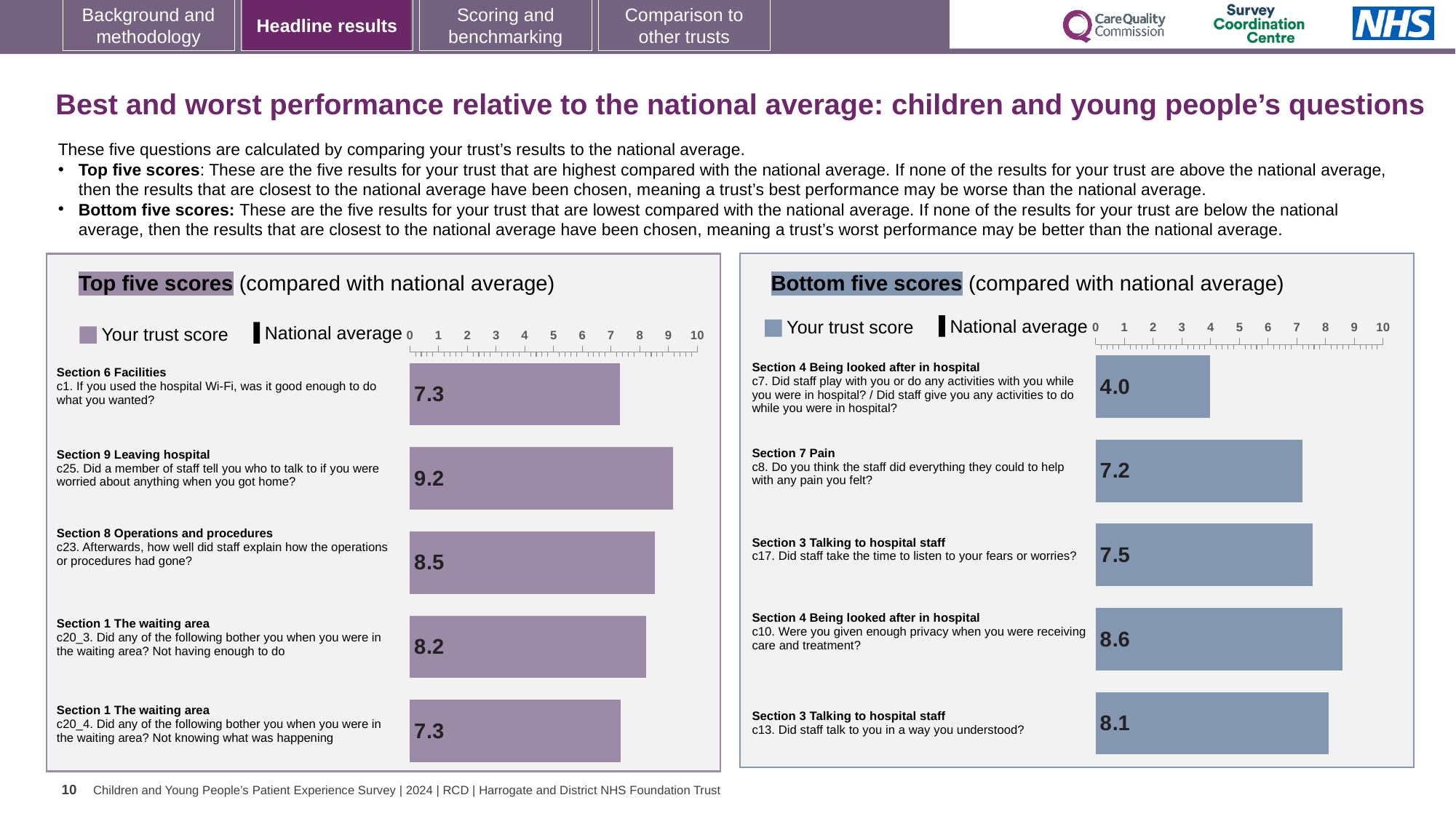
In the Bottom five scores chart, is the trust score for c8 (staff did everything they could to help with pain) greater or less than 5? greater In the Top five scores chart, what is the difference between the trust scores for c25 and c23? 0.7 In the Bottom five scores chart, which has the higher trust score: c10 (privacy when receiving care) or c13 (staff talk to you in a way you understood)? c10 In the Bottom five scores chart, which question has the lowest trust score? c7 (Section 4 Being looked after in hospital) What type of chart is used for the Bottom five scores? Bar chart In the Bottom five scores chart, what is the difference between the trust scores for c10 and c7? 4.6 How many questions are shown in the Top five scores chart? 5 In the Top five scores chart, which question has the highest trust score? c25 (Section 9 Leaving hospital) In the Top five scores chart, what is the trust score for c20_3 (Not having enough to do in the waiting area)? 8.2 In the Top five scores chart, what is the trust score for c25 (Did a member of staff tell you who to talk to if you were worried about anything when you got home?)? 9.2 In the Bottom five scores chart, what is the trust score for c7 (Did staff play with you or do any activities with you while you were in hospital?)? 4.0 What two entries does the legend of the Top five scores chart list? Your trust score; National average